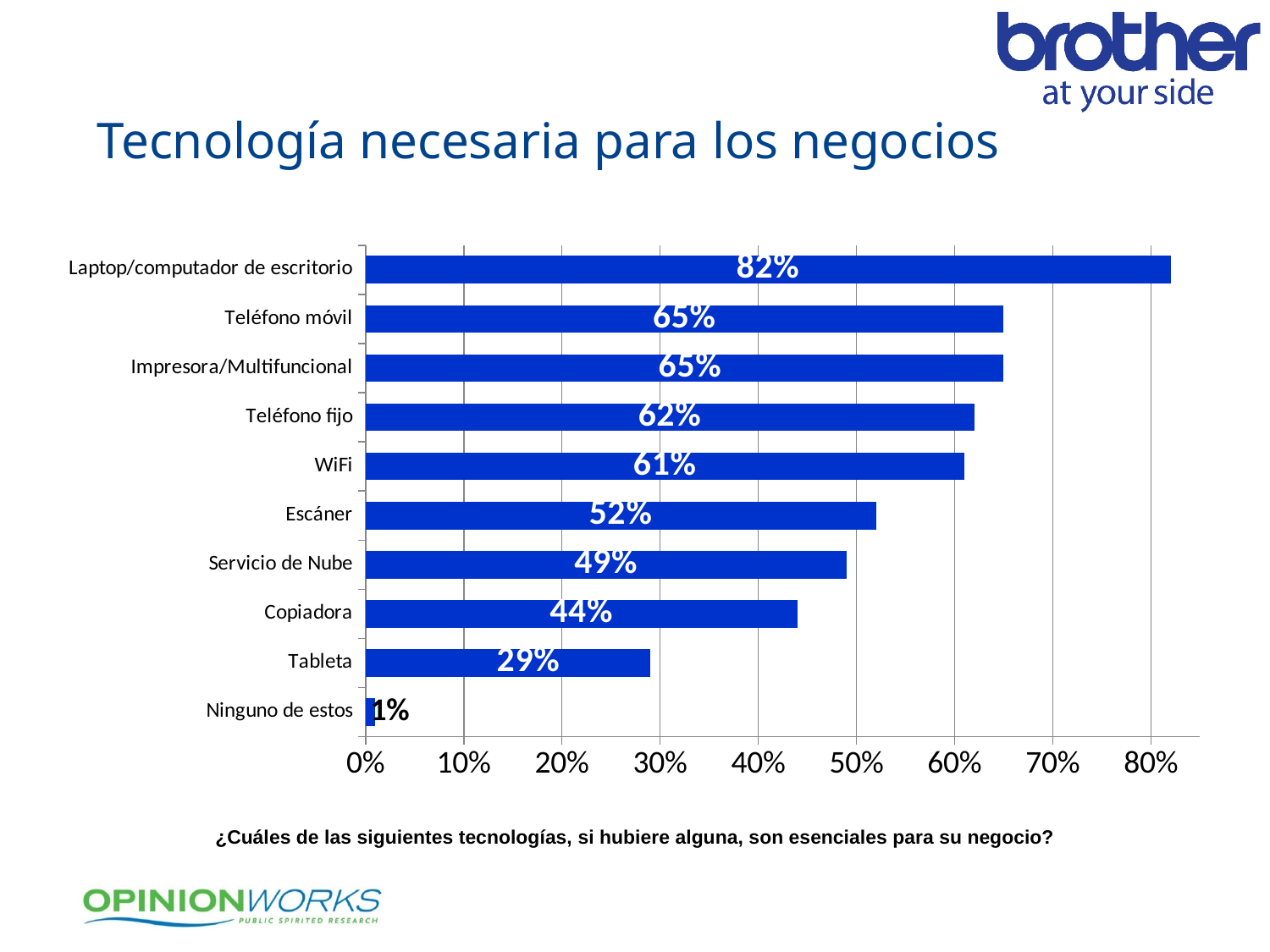
What is the value for Tableta? 29% What is the value for WiFi? 61% Which category has the lowest value? Ninguno de estos What is the value for Laptop/computador de escritorio? 82% How many categories are shown in the chart? 10 What is the title of the slide? Tecnología necesaria para los negocios What is the difference between the values for Escáner and Copiadora? 8% Which category has the highest value? Laptop/computador de escritorio What is the difference between the values for Laptop/computador de escritorio and Teléfono móvil? 17% Is the value for Teléfono fijo greater or less than 50%? greater What kind of chart is shown on the slide? bar chart Which is larger, the value for Servicio de Nube or the value for Tableta? Servicio de Nube